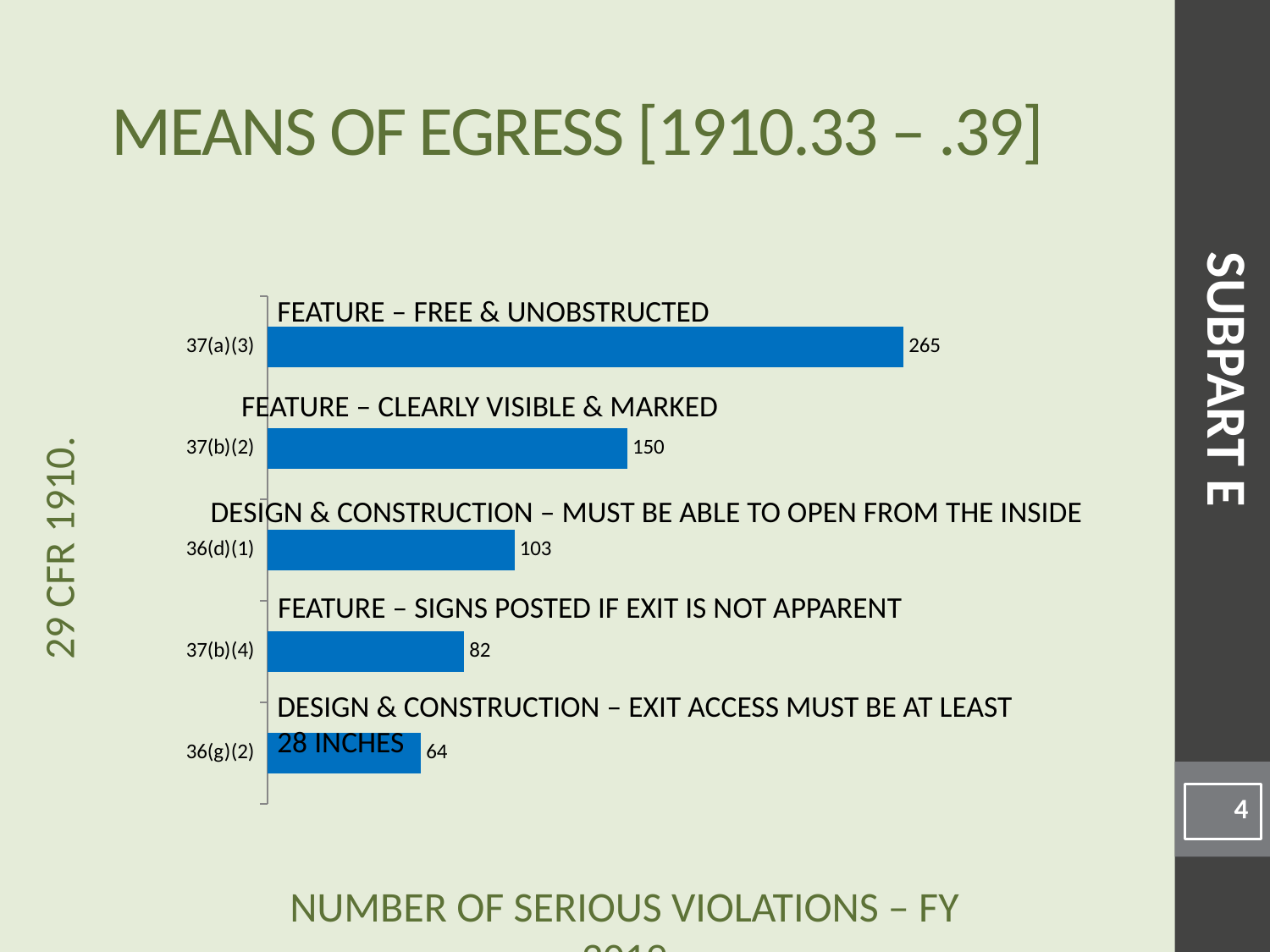
What is the number of serious violations for 37(b)(4)? 82 What is the number of serious violations for 36(d)(1)? 103 What is the number of serious violations for 36(g)(2)? 64 How many categories are shown in the chart? 5 What is the difference between the values for 37(a)(3) and 37(b)(2)? 115 Which category has the lowest number of serious violations? 36(g)(2) Which has more serious violations, 36(d)(1) or 37(b)(4)? 36(d)(1) Which category has the highest number of serious violations? 37(a)(3) What is the difference between the values for 37(b)(4) and 36(g)(2)? 18 What is the number of serious violations for 37(a)(3)? 265 What is the number of serious violations for 37(b)(2)? 150 What kind of chart is shown on the slide? Bar chart